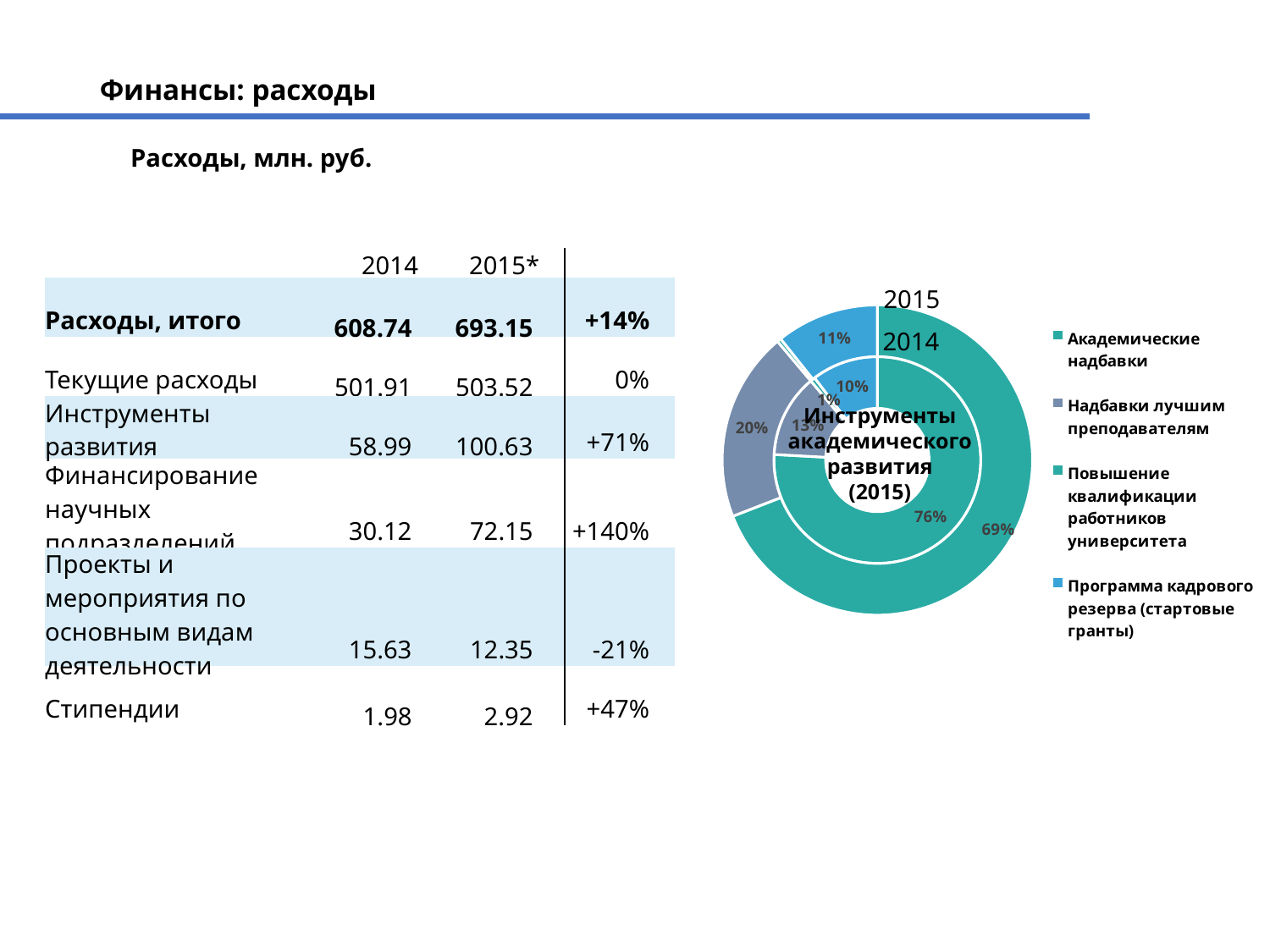
Which category has the largest share in the 2015 ring of the doughnut chart? Академические надбавки In the 2015 ring of the doughnut chart, what share is labelled for Надбавки лучшим преподавателям? 20% How many entries does the legend of the doughnut chart list? 4 In the 2014 ring of the doughnut chart, what share is labelled for Надбавки лучшим преподавателям? 13% In the 2014 ring of the doughnut chart, what share is labelled for Академические надбавки? 76% In the 2015 ring of the doughnut chart, what share is labelled for Программа кадрового резерва (стартовые гранты)? 11% What is the title of the doughnut chart? Инструменты академического развития (2015) In the 2015 ring, which is larger: the share for Надбавки лучшим преподавателям or the share for Программа кадрового резерва (стартовые гранты)? Надбавки лучшим преподавателям In the 2014 ring of the doughnut chart, what share is labelled for Программа кадрового резерва (стартовые гранты)? 10% In the 2015 ring of the doughnut chart, what share is labelled for Академические надбавки? 69% What kind of chart is shown on the slide? Doughnut chart By how many percentage points did the share of Академические надбавки change from the 2014 ring (76%) to the 2015 ring (69%)? 7 percentage points